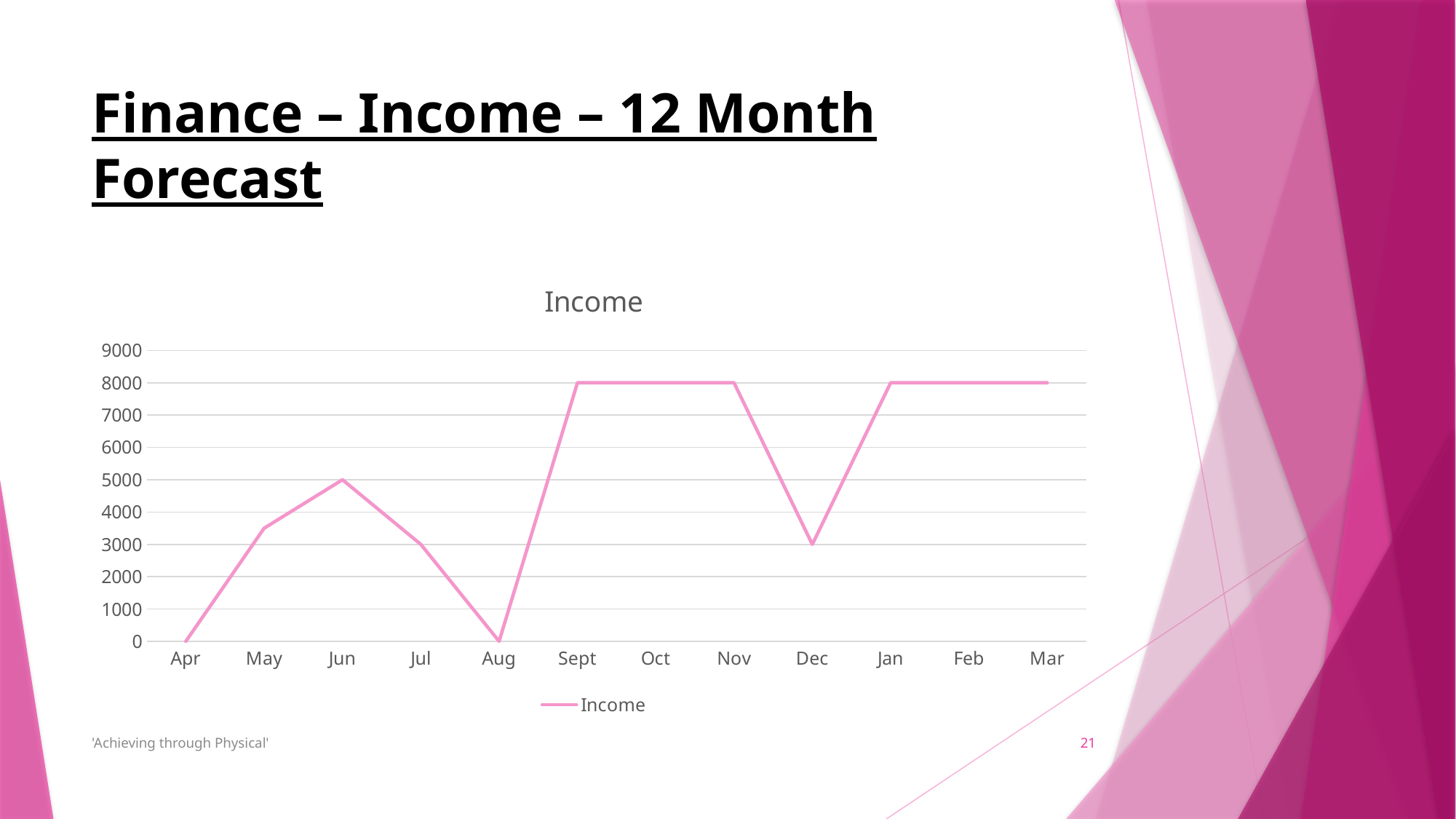
What kind of chart is shown on the slide? line chart What is the Income value for Dec? 3000 How many months are plotted along the x axis of the Income chart? 12 Is the Income value for May greater or less than 3000? greater What is the Income value for Jun? 5000 What is the Income value for Apr? 0 What is the difference between the Income values for Jun and Jul? 2000 Which month has the higher Income value, Jun or Jul? Jun What is the difference between the Income values for Sept and Dec? 5000 How many series does the legend of the Income chart list? 1 What is the Income value for Sept? 8000 Does the Income value rise or fall from Apr to Jun? rise